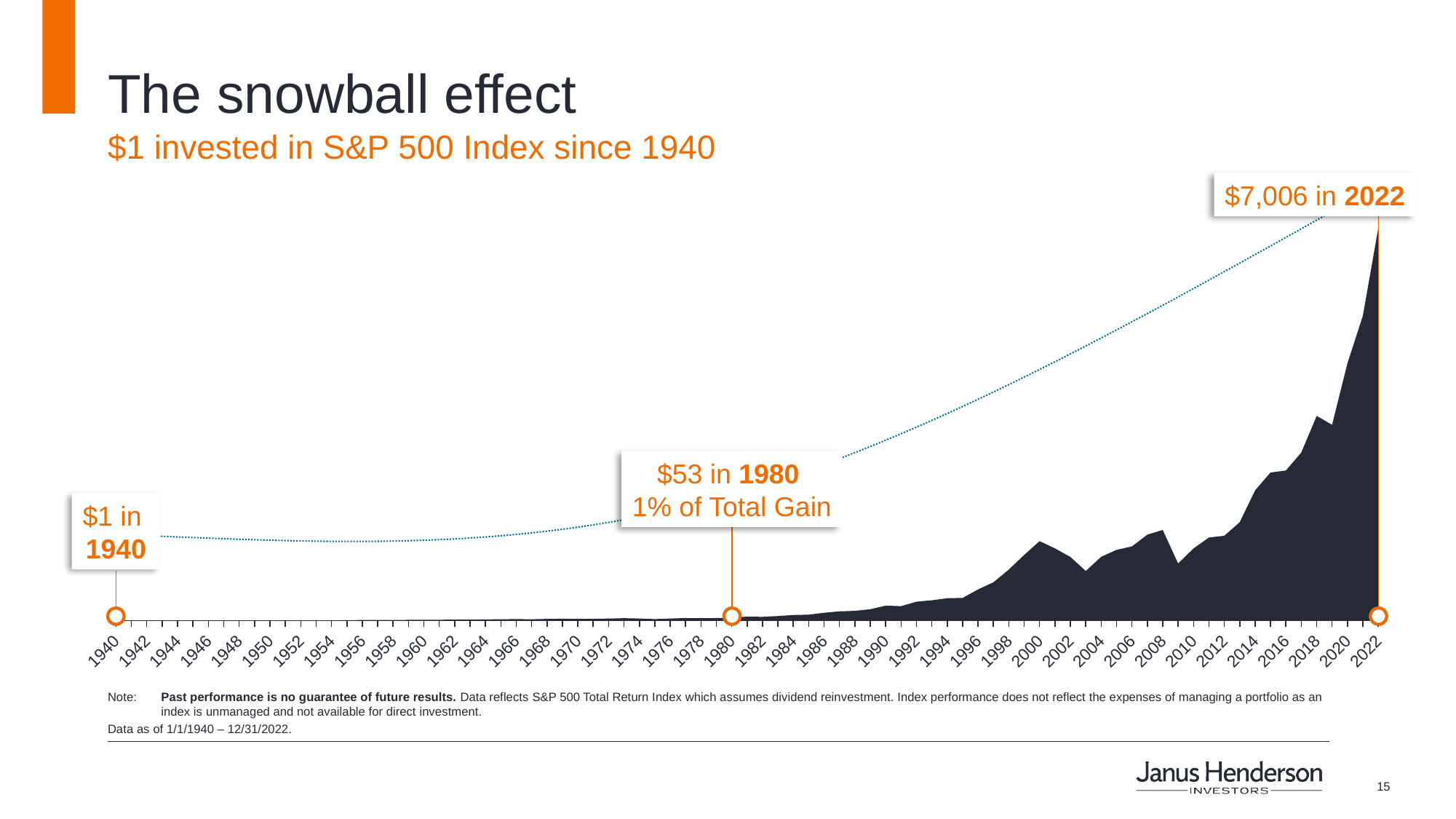
Does the value of the investment generally rise or fall from 1940 to 2022? Rise In which labeled year is the investment value lowest? 1940 What is the difference between the labeled value in 2022 and the labeled value in 1980? $6,953 What is the difference between the labeled value in 1980 and the labeled value in 1940? $52 What is the value of the investment in 1940 according to the chart's label? $1 What is the value of the investment in 1980 according to the chart's label? $53 What is the value of the investment in 2022 according to the chart's label? $7,006 Which year has the higher labeled value, 1980 or 2022? 2022 What kind of chart is shown on the slide? Area chart What percentage of the total gain had been achieved by 1980, according to the chart's label? 1% In which labeled year does the investment reach its highest value? 2022 What is the subtitle of the chart on the slide? $1 invested in S&P 500 Index since 1940